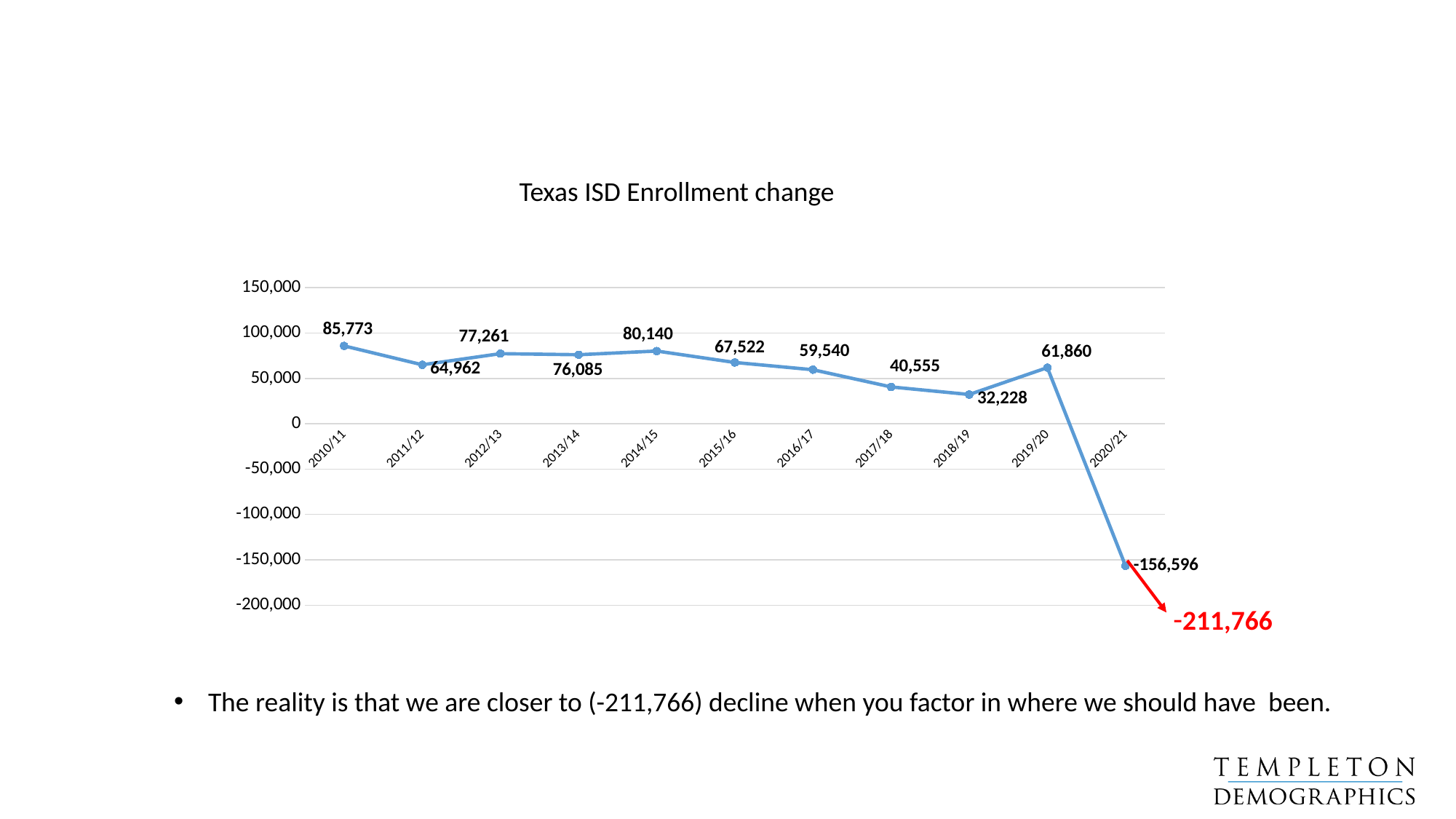
What is the enrollment change value for 2020/21? -156,596 What is the enrollment change value for 2018/19? 32,228 How many school years are plotted on the chart? 11 What kind of chart is shown on the slide? line chart What value does the red arrow annotation point to below the 2020/21 data point? -211,766 What is the title of the chart? Texas ISD Enrollment change Which is larger, the enrollment change for 2012/13 or for 2013/14? 2012/13 What is the difference between the enrollment change in 2019/20 and 2018/19? 29,632 What is the enrollment change value for 2010/11? 85,773 Which school year has the lowest enrollment change? 2020/21 Which school year has the highest enrollment change? 2010/11 Is the value for 2017/18 greater or less than 50,000? less